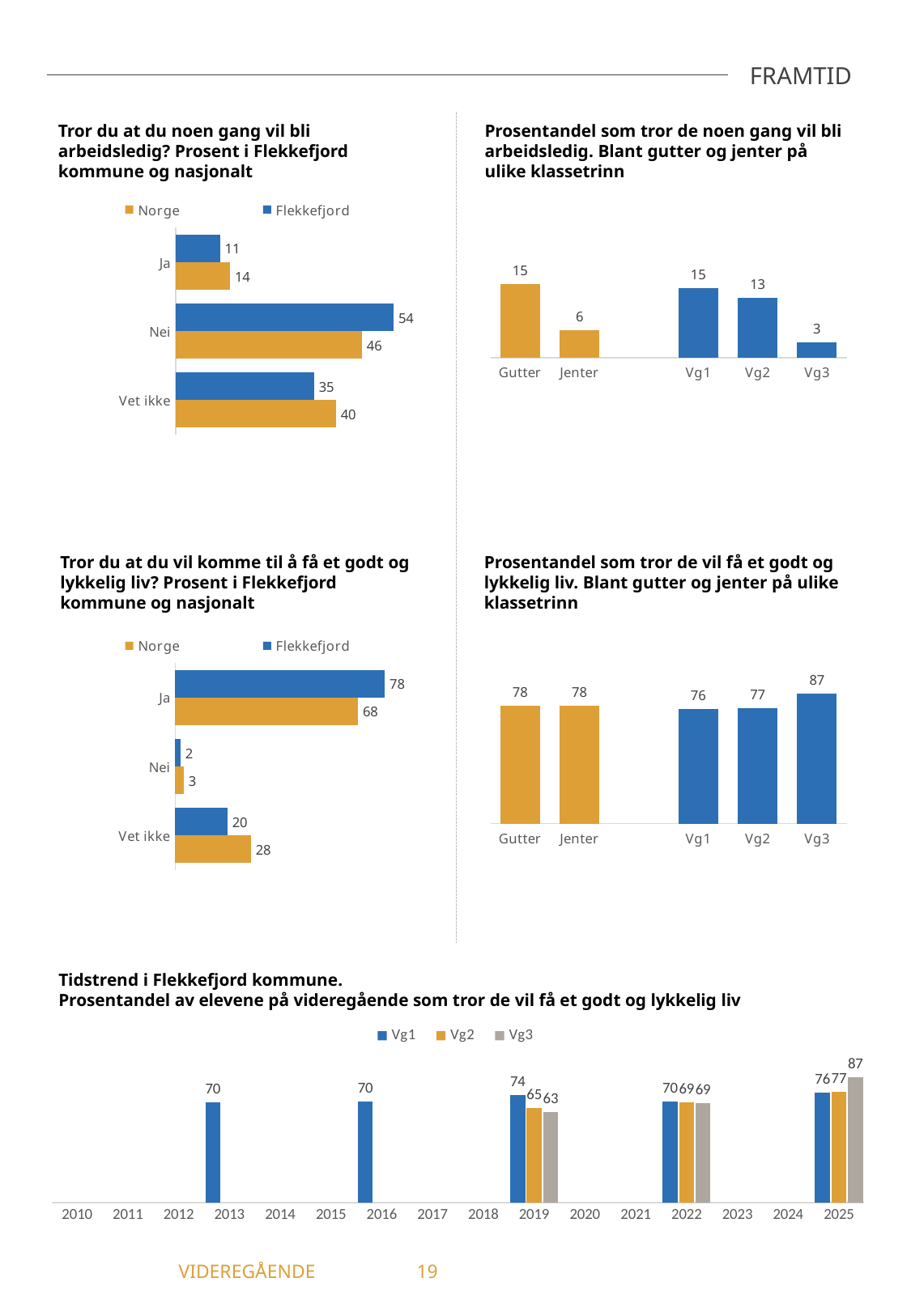
In the top-right chart 'Prosentandel som tror de noen gang vil bli arbeidsledig', how many categories are shown? 5 In the top-left chart 'Tror du at du noen gang vil bli arbeidsledig?', how many series does the legend list? 2 In the middle-right chart 'Prosentandel som tror de vil få et godt og lykkelig liv', which category has the highest value? Vg3 What kind of chart is the middle-left chart 'Tror du at du vil komme til å få et godt og lykkelig liv?'? Bar chart In the top-left chart 'Tror du at du noen gang vil bli arbeidsledig?', what is the value for Flekkefjord for 'Nei'? 54 In the bottom chart 'Tidstrend i Flekkefjord kommune', what is the difference between the Vg3 values in 2025 and 2022? 18 In the bottom chart 'Tidstrend i Flekkefjord kommune', what is the value for Vg2 in 2019? 65 In the top-right chart 'Prosentandel som tror de noen gang vil bli arbeidsledig', which category has the lowest value? Vg3 In the middle-left chart 'Tror du at du vil komme til å få et godt og lykkelig liv?', what is the value for Norge for 'Ja'? 68 In the top-right chart 'Prosentandel som tror de noen gang vil bli arbeidsledig', what is the value for Jenter? 6 In the top-left chart 'Tror du at du noen gang vil bli arbeidsledig?', what is the difference between the Norge and Flekkefjord values for 'Vet ikke'? 5 In the middle-left chart 'Tror du at du vil komme til å få et godt og lykkelig liv?', which is larger for 'Vet ikke': Norge or Flekkefjord? Norge